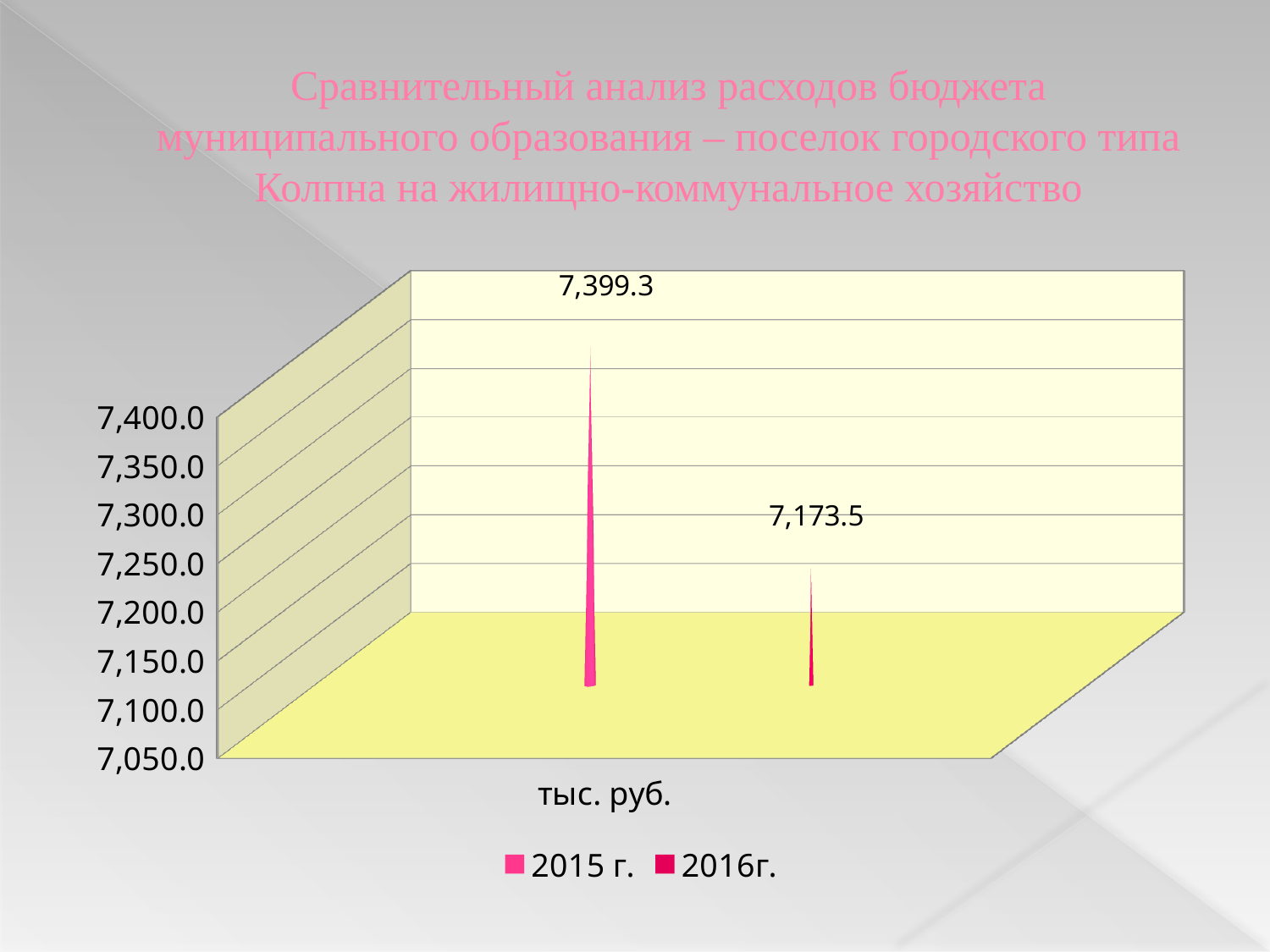
What kind of chart is shown on the slide? bar chart Which series has the higher value, 2015 г. or 2016г.? 2015 г. Do the values fall or rise from 2015 г. to 2016г.? fall What unit label is shown below the chart's category axis? тыс. руб. Is the value for 2016г. larger or smaller than the value for 2015 г.? smaller Which series has the lower value? 2016г. What is the value for 2016г.? 7,173.5 How many series does the legend list? 2 What is the value for 2015 г.? 7,399.3 What is the difference between the 2015 г. value and the 2016г. value? 225.8 Is the value for 2016г. greater or less than 7,200.0? less Is the value for 2015 г. greater or less than 7,350.0? greater